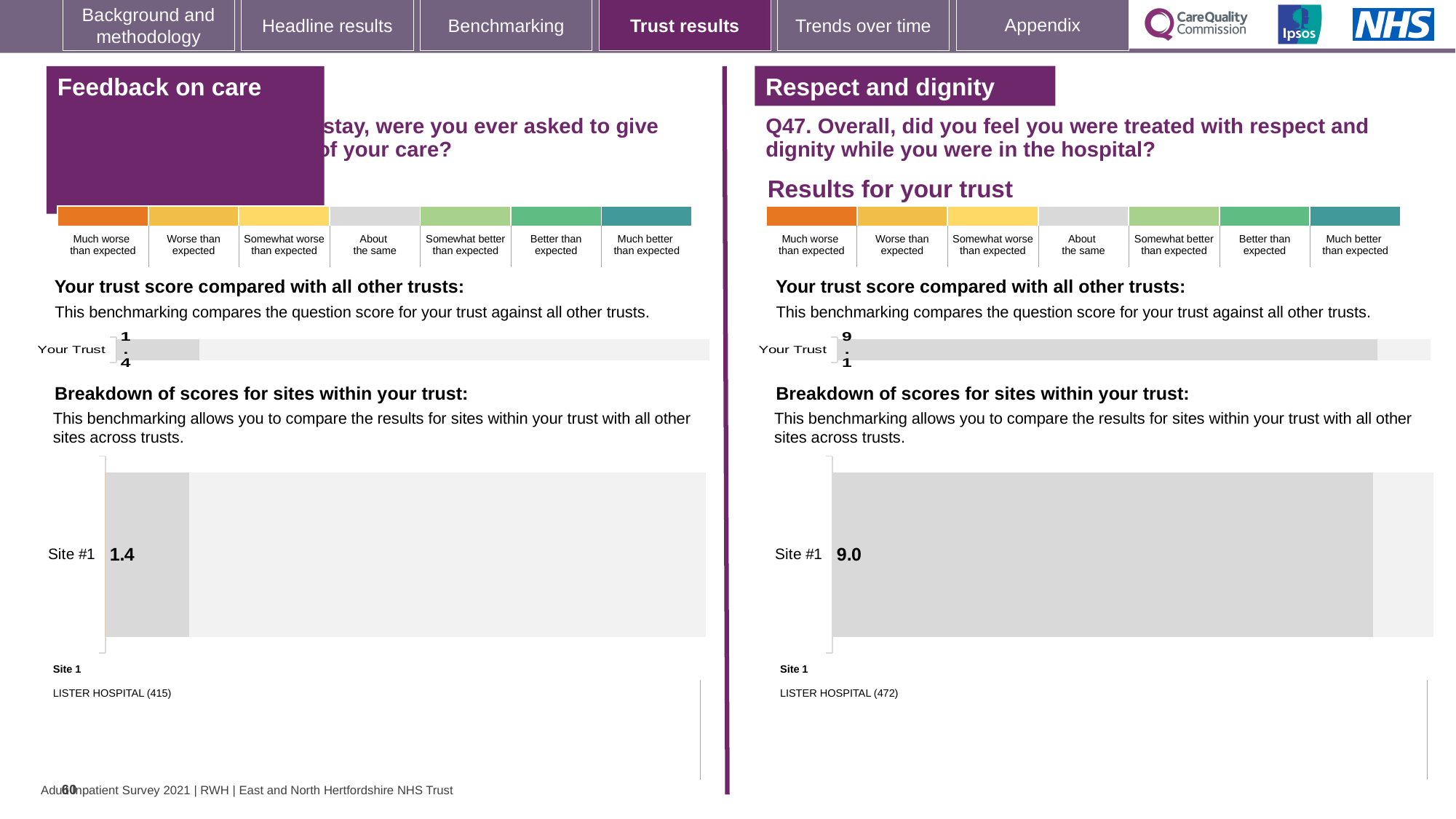
What is the difference between the Site #1 score in the Respect and dignity section and the Site #1 score in the Feedback on care section? 7.6 Which hospital is listed as Site 1 below the site breakdown chart in the Feedback on care section? LISTER HOSPITAL (415) What kind of chart is used to show the Site #1 score in the Respect and dignity section? bar chart Which is larger: the Site #1 score in the Feedback on care section or the Site #1 score in the Respect and dignity section? Respect and dignity On the Feedback on care section, what is the score shown for Site #1 in the site breakdown chart? 1.4 How many sites are plotted in the site breakdown chart of the Feedback on care section? 1 Which hospital is listed as Site 1 below the site breakdown chart in the Respect and dignity section? LISTER HOSPITAL (472) On the Respect and dignity section, what is the score shown for Your Trust in the trust comparison bar chart? 9.1 What is the difference between the Your Trust score (9.1) and the Site #1 score (9.0) in the Respect and dignity section? 0.1 On the Feedback on care section, what is the score shown for Your Trust in the trust comparison bar chart? 1.4 How many sites are plotted in the site breakdown chart of the Respect and dignity section? 1 On the Respect and dignity section, what is the score shown for Site #1 in the site breakdown chart? 9.0